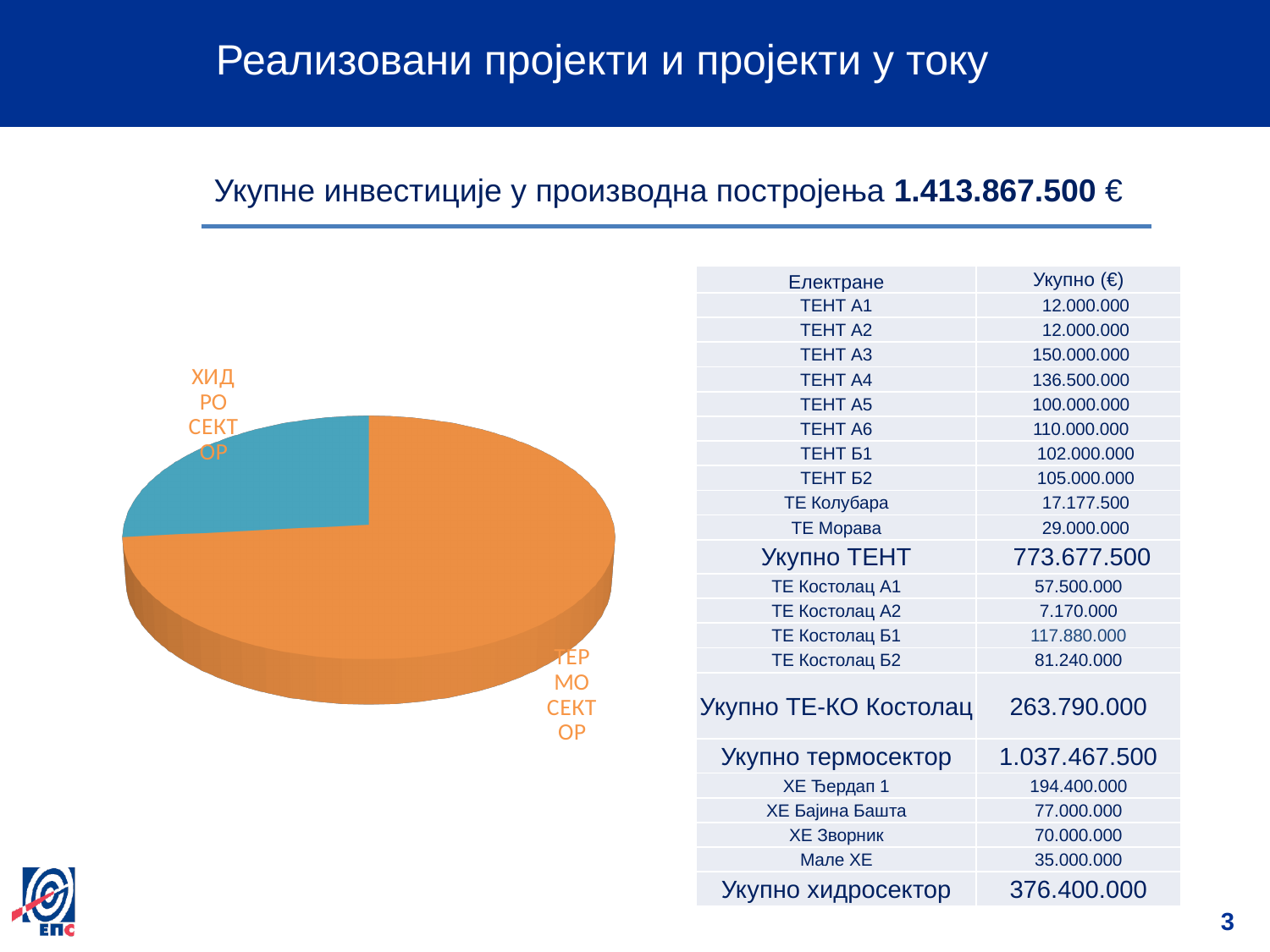
Does the ХИДРОСЕКТОР slice take up more or less than half of the pie chart? less What colour is the ХИДРОСЕКТОР slice in the pie chart? blue In the pie chart, which is larger: ТЕРМОСЕКТОР or ХИДРОСЕКТОР? ТЕРМОСЕКТОР Which slice of the pie chart is the largest? ТЕРМОСЕКТОР How many slices does the pie chart have? 2 What colour is the ТЕРМОСЕКТОР slice in the pie chart? orange What kind of chart is shown on the left of the slide? pie chart Does the ТЕРМОСЕКТОР slice take up more or less than half of the pie chart? more Which slice of the pie chart is the smallest? ХИДРОСЕКТОР